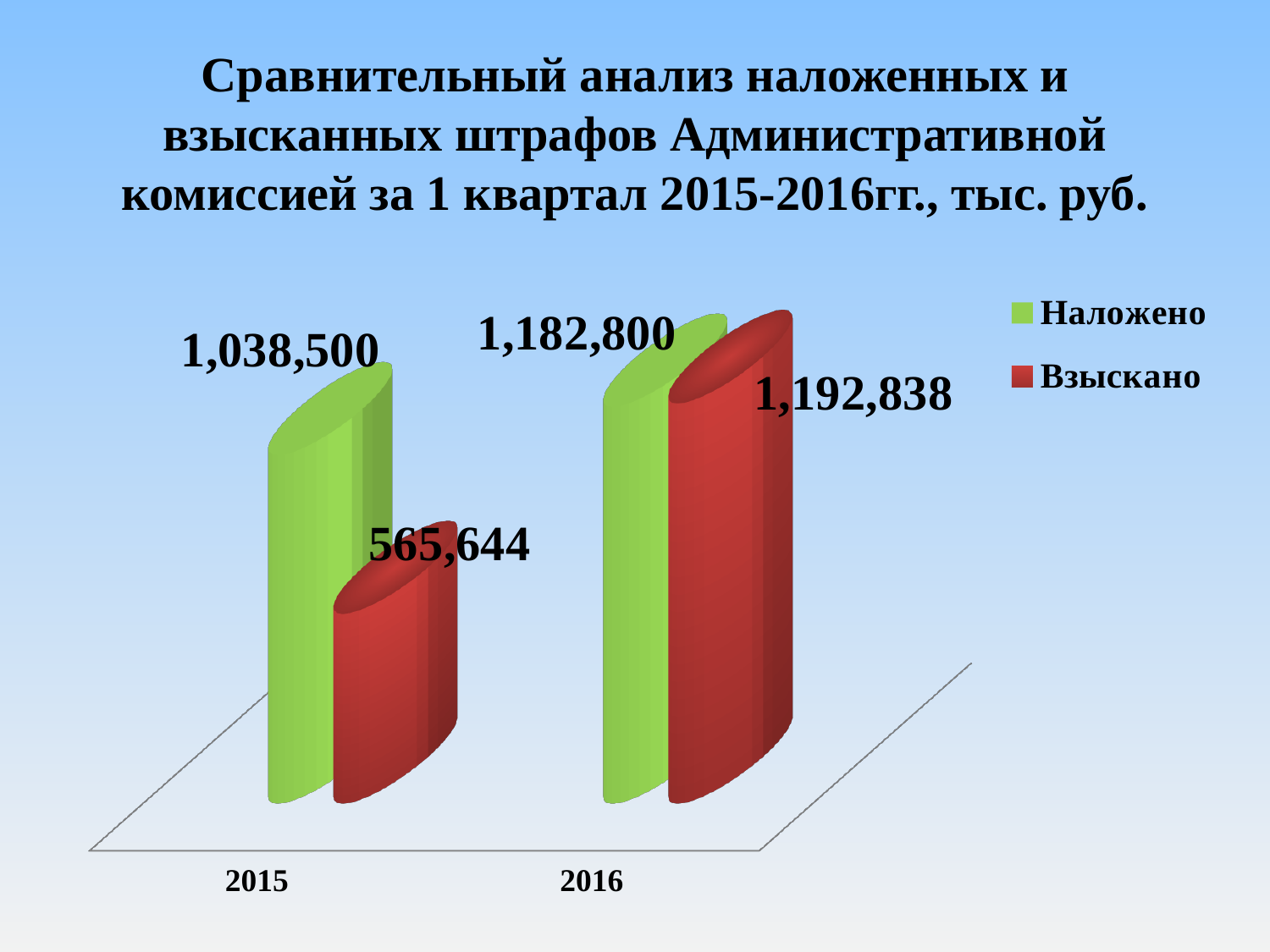
Which colour represents the Взыскано series? Red What is the value for Взыскано in 2016? 1,192,838 How many series does the legend list? 2 Which bar has the lowest value on the chart? Взыскано in 2015 What is the difference between Взыскано in 2016 and Взыскано in 2015? 627,194 What is the value for Наложено in 2015? 1,038,500 What is the value for Наложено in 2016? 1,182,800 What is the value for Взыскано in 2015? 565,644 Which is larger in 2016: Наложено or Взыскано? Взыскано What kind of chart is shown on the slide? Bar chart What is the difference between Наложено and Взыскано in 2015? 472,856 Which bar has the highest value on the chart? Взыскано in 2016